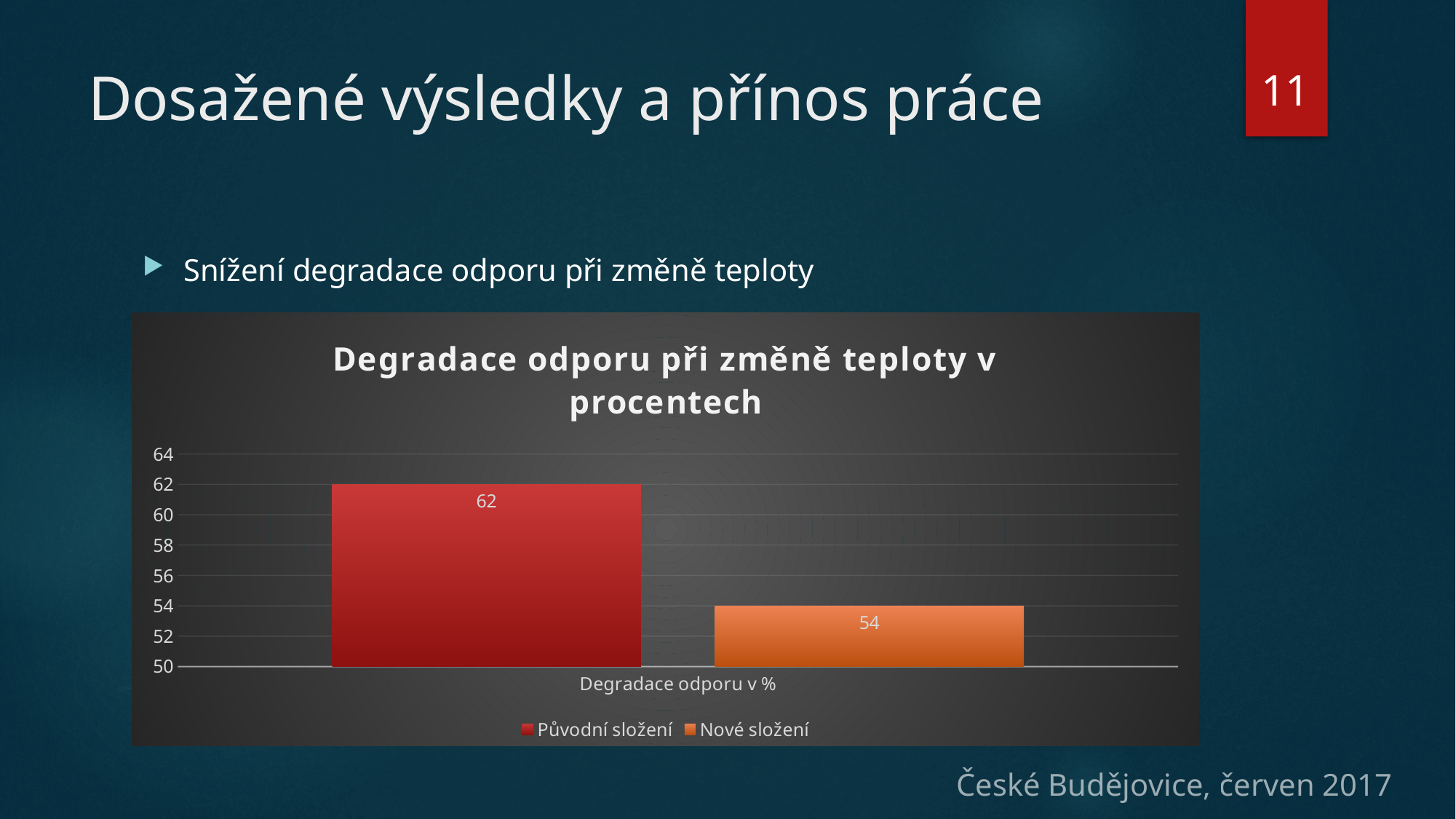
What is the title of the chart? Degradace odporu při změně teploty v procentech What is the category label on the x axis? Degradace odporu v % How many bars are plotted in the chart? 2 How many series does the legend list? 2 What is the value for Nové složení? 54 Is the value for Nové složení greater or less than 60? less Which series has the lower value? Nové složení What is the difference between the values for Původní složení and Nové složení? 8 What is the value for Původní složení? 62 Which series has the higher value, Původní složení or Nové složení? Původní složení Is the value for Původní složení greater or less than 58? greater What kind of chart is shown on the slide? bar chart